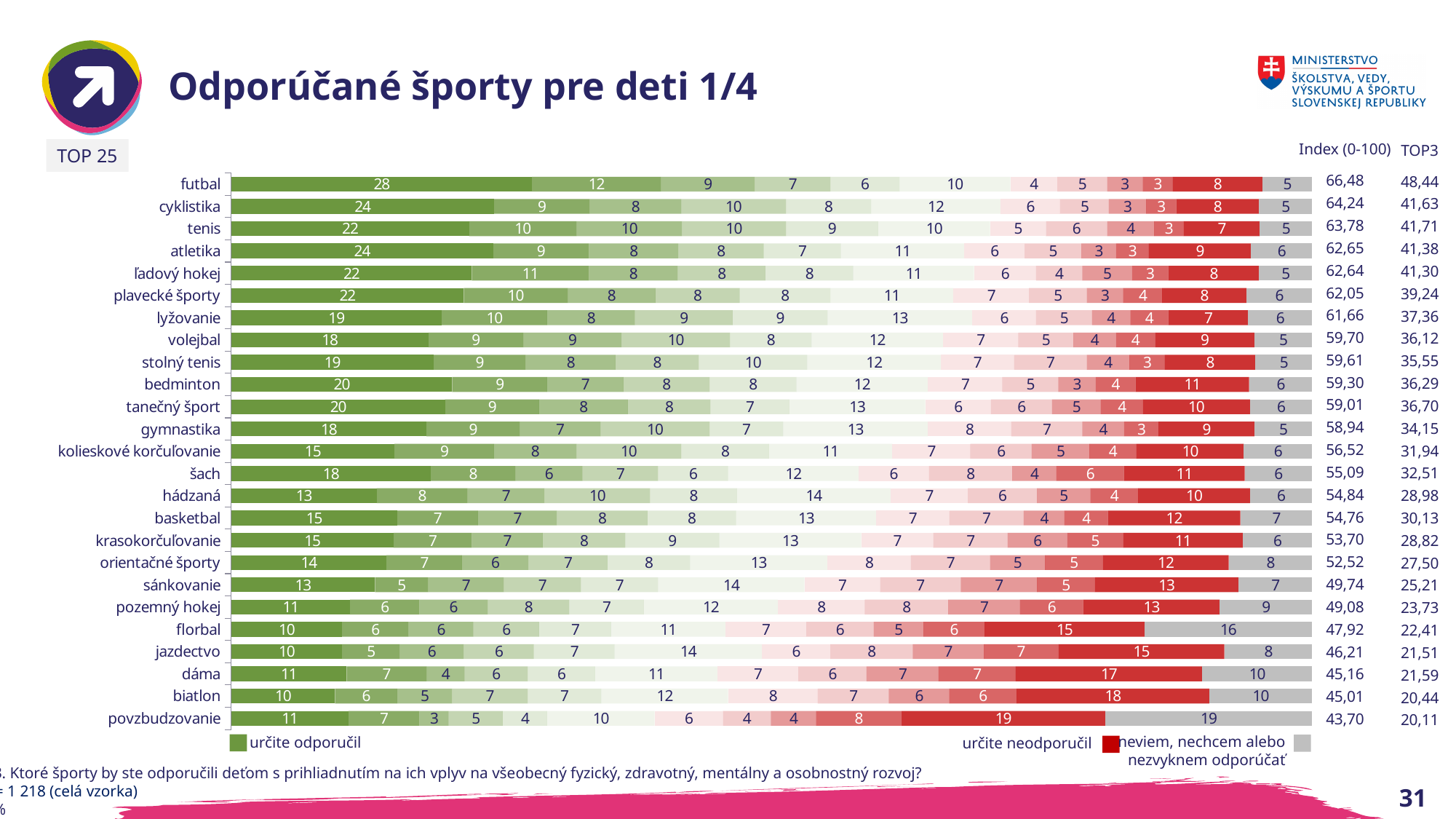
What is the total of all segments in the futbal bar? 100 What kind of chart is shown on the slide? bar chart What is the difference between the 'určite odporučil' values for futbal and cyklistika? 4 What is the 'určite neodporučil' value for dáma? 17 What is the 'určite odporučil' value for povzbudzovanie? 11 Which sport has the highest 'určite neodporučil' value? povzbudzovanie What is the 'neviem, nechcem alebo nezvyknem odporúčať' value for florbal? 16 How many sports are listed in the chart? 25 Which sport has the highest 'určite odporučil' value? futbal What is the 'určite odporučil' value for futbal? 28 Which has a larger 'určite odporučil' value, bedminton or šach? bedminton What is the first legend entry shown below the chart? určite odporučil